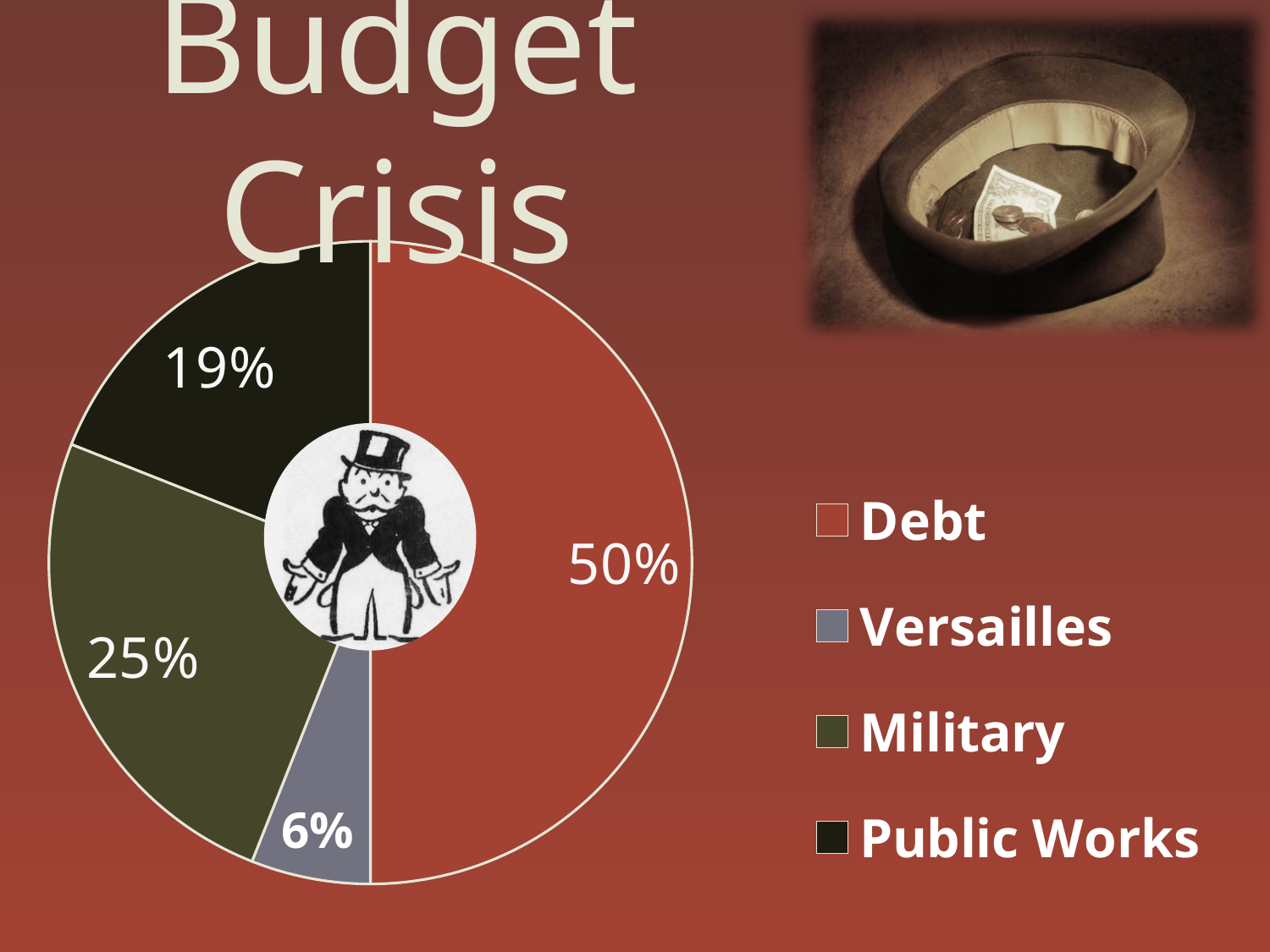
What share of the pie does Military take? 25% Which category has the smallest slice of the pie? Versailles What is the difference in percentage points between the Debt slice and the Military slice? 25 What kind of chart is shown on the slide? Pie chart Which slice is larger, Military or Public Works? Military What share of the pie does Public Works take? 19% How many slices does the pie chart have? 4 What share of the pie does Versailles take? 6% What share of the pie does Debt take? 50% What is the title shown above the chart? Budget Crisis Which category has the largest slice of the pie? Debt Which legend entry is shown in the darkest colour? Public Works